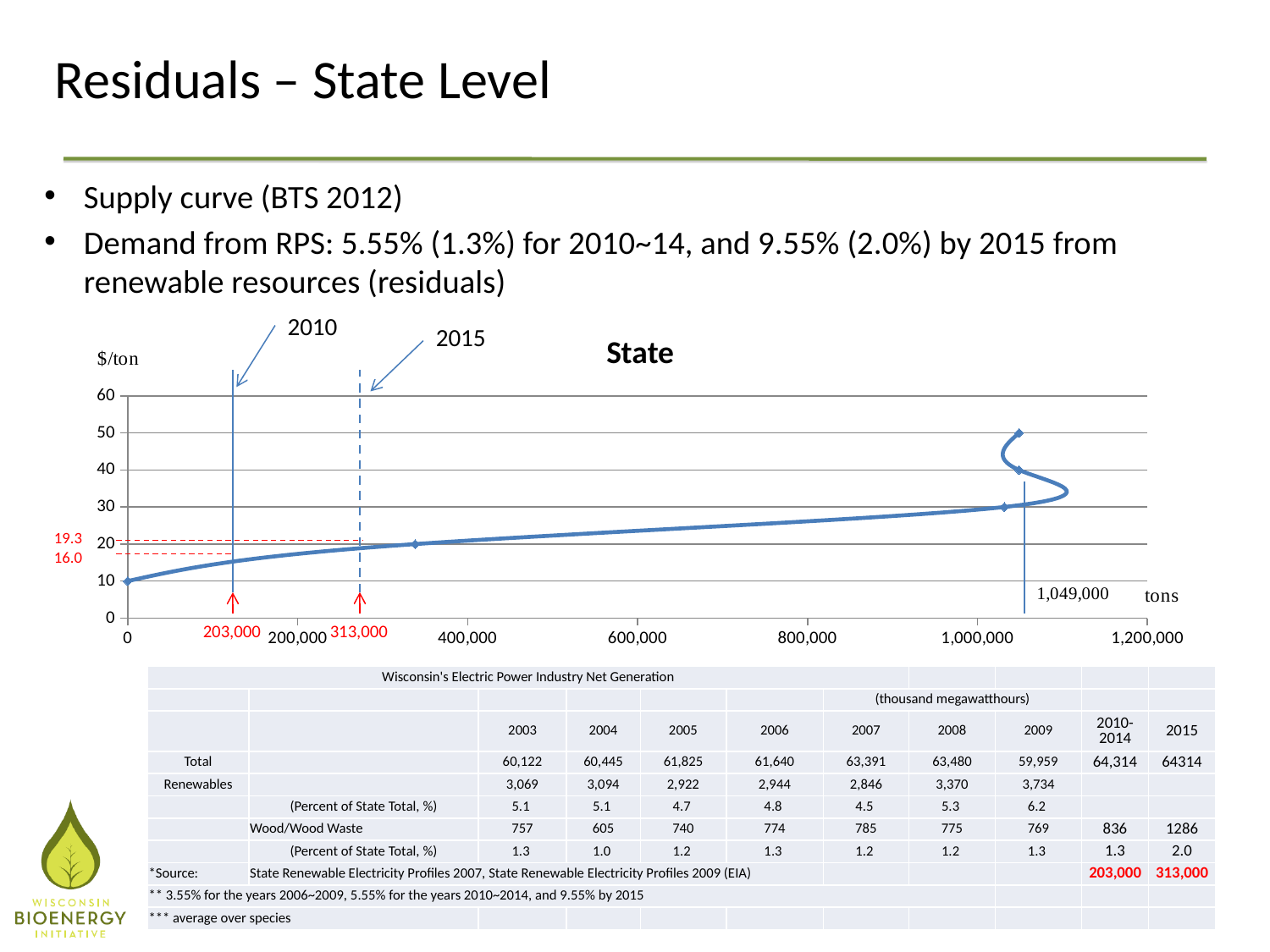
Is the price on the supply curve at 1,000,000 tons greater or less than 20 $/ton? greater What is the difference in $/ton between the 2015 price (19.3) and the 2010 price (16.0) marked on the chart? 3.3 What is the title of the chart? State What price ($/ton) is marked where the 2010 demand line meets the supply curve? 16.0 What kind of chart is the "State" chart? line chart What price ($/ton) is marked where the 2015 demand line meets the supply curve? 19.3 What unit is shown on the vertical axis of the chart? $/ton What quantity in tons is marked for the 2015 demand line on the chart? 313,000 What quantity in tons is marked for the 2010 demand line on the chart? 203,000 What quantity in tons is labelled at the vertical line near the right end of the supply curve? 1,049,000 Does the supply curve generally rise or fall as tons increase along the x axis? rise What is the difference in tons between the 2015 and 2010 demand quantities marked on the chart? 110,000